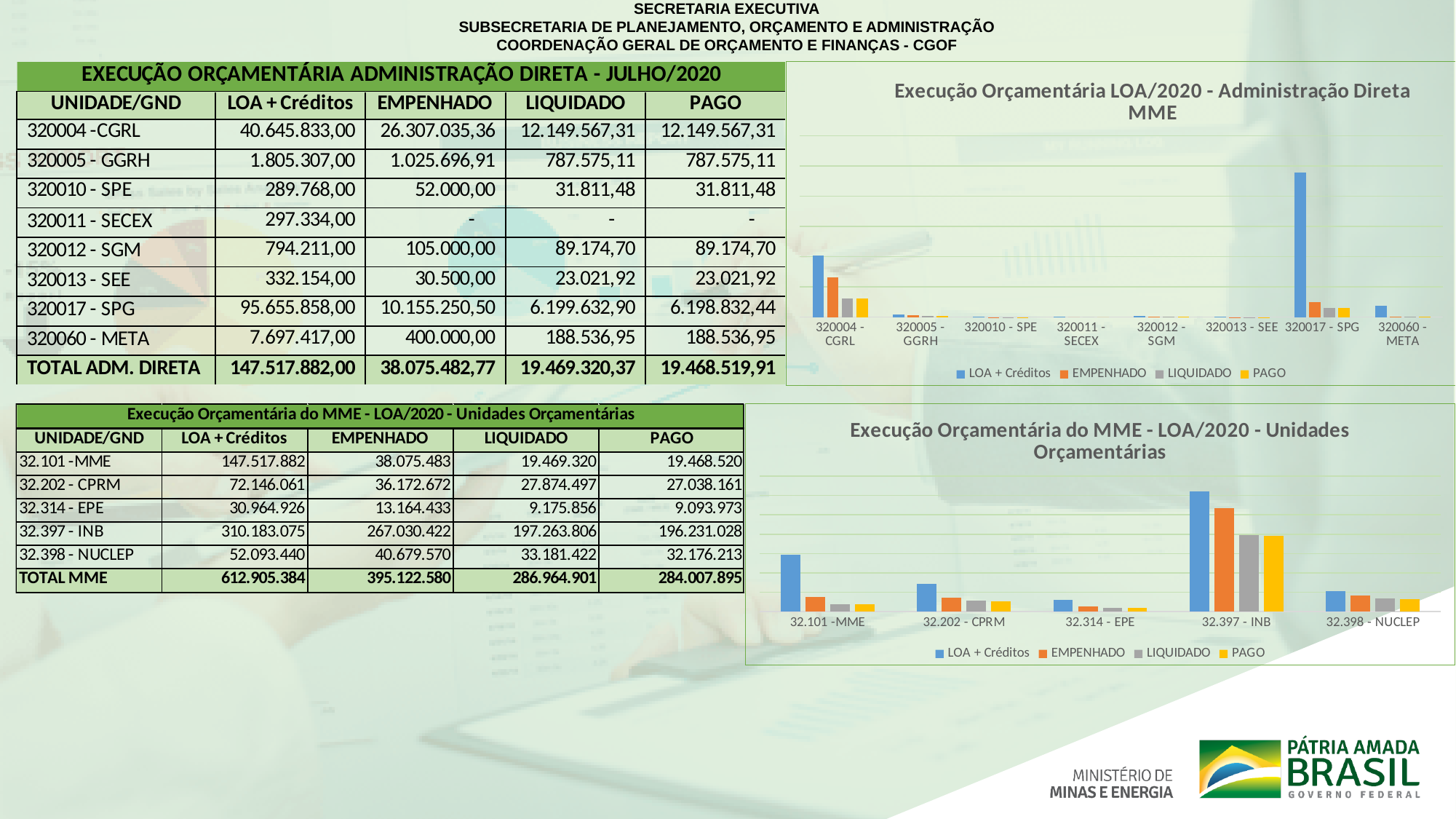
In the bottom-right chart (Unidades Orçamentárias), which category has the highest LOA + Créditos bar? 32.397 - INB Which colour represents the PAGO series in the legend of the bottom-right chart (Unidades Orçamentárias)? yellow In the bottom-right chart (Unidades Orçamentárias), which is larger for LOA + Créditos: 32.101 -MME or 32.202 - CPRM? 32.101 -MME In the top-right chart (Administração Direta MME), which is larger for EMPENHADO: 320004 - CGRL or 320017 - SPG? 320004 - CGRL How many series does the legend of the top-right chart (Administração Direta MME) list? 4 What kind of chart is the top-right chart titled 'Execução Orçamentária LOA/2020 - Administração Direta MME'? bar chart What kind of chart is the bottom-right chart titled 'Execução Orçamentária do MME - LOA/2020 - Unidades Orçamentárias'? bar chart In the top-right chart (Administração Direta MME), which is larger for LOA + Créditos: 320004 - CGRL or 320060 - META? 320004 - CGRL How many categories are shown on the x axis of the top-right chart (Administração Direta MME)? 8 In the bottom-right chart (Unidades Orçamentárias), which category has the lowest LOA + Créditos bar? 32.314 - EPE In the top-right chart (Administração Direta MME), which category has the highest LOA + Créditos bar? 320017 - SPG How many categories are shown on the x axis of the bottom-right chart (Unidades Orçamentárias)? 5